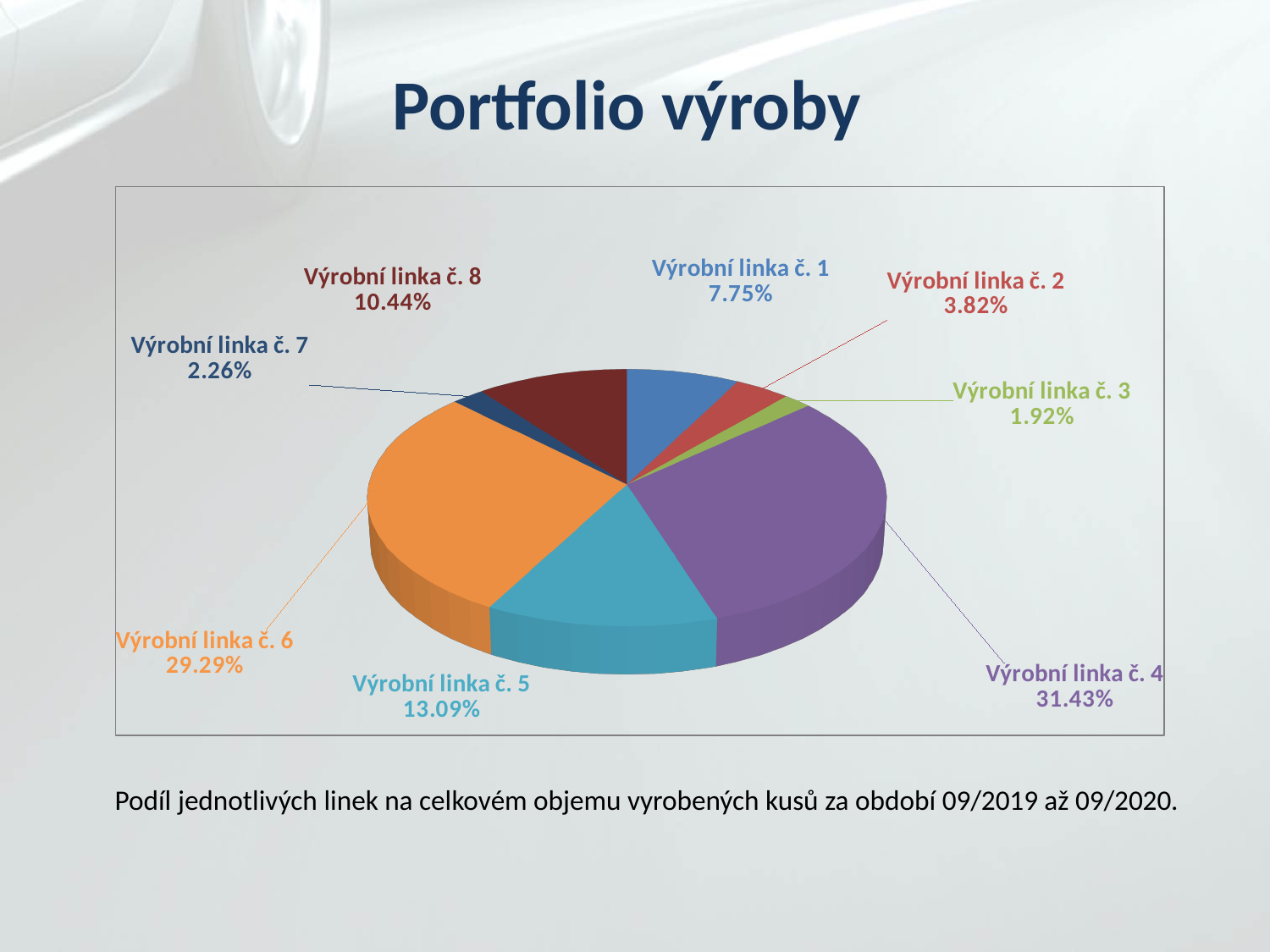
Which production line has the smallest share of the pie? Výrobní linka č. 3 What is the value shown for Výrobní linka č. 8? 10.44% What is the difference in percentage points between Výrobní linka č. 5 and Výrobní linka č. 8? 2.65 Which has a larger share, Výrobní linka č. 1 or Výrobní linka č. 2? Výrobní linka č. 1 What share of the pie does Výrobní linka č. 4 have? 31.43% How many slices does the pie chart have? 8 What is the title of the slide containing the chart? Portfolio výroby Which production line has the largest share of the pie? Výrobní linka č. 4 What type of chart is shown on the slide? pie chart What is the value shown for Výrobní linka č. 3? 1.92% What is the value shown for Výrobní linka č. 6? 29.29% What is the difference in percentage points between Výrobní linka č. 4 and Výrobní linka č. 6? 2.14